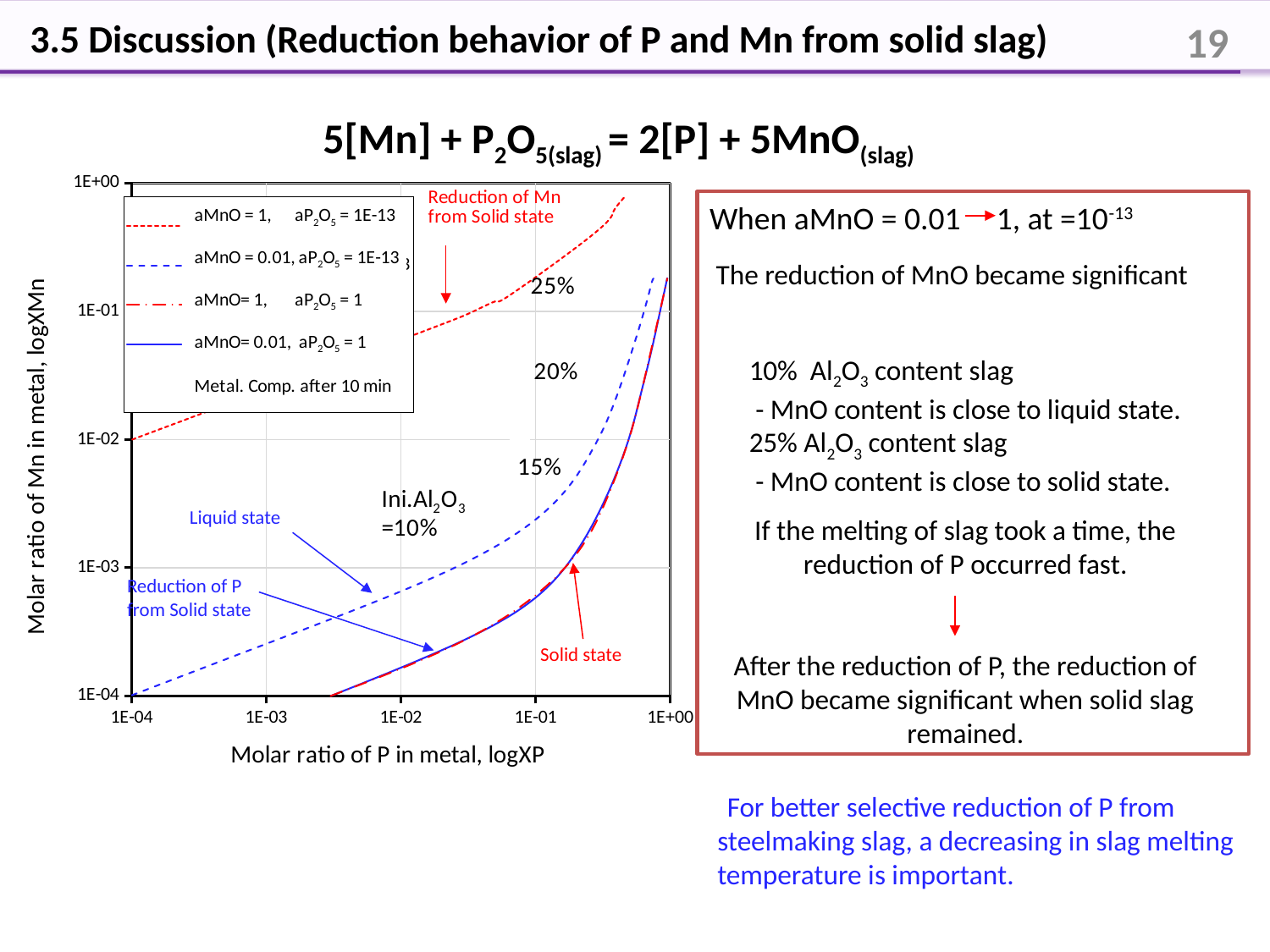
What kind of chart is shown on the slide? line chart Which legend series has the highest values across the plotted range? aMnO = 1, aP2O5 = 1E-13 At x = 1E-02, which series is higher: aMnO = 1, aP2O5 = 1E-13 or aMnO = 0.01, aP2O5 = 1E-13? aMnO = 1, aP2O5 = 1E-13 How many tick labels are shown on the x axis of the chart? 5 At x = 1E-02, is the value of the aMnO = 0.01, aP2O5 = 1 curve greater or less than 1E-03? less At x = 1E-01, is the value of the aMnO = 0.01, aP2O5 = 1E-13 curve greater or less than 1E-03? greater At x = 1E-03, is the value of the aMnO = 1, aP2O5 = 1E-13 curve greater or less than 1E-02? greater What is the title of the x axis of the chart? Molar ratio of P in metal, logXP Do the curves rise or fall as the molar ratio of P in metal increases along the x axis? rise Which two legend series overlap almost completely on the chart? aMnO = 1, aP2O5 = 1 and aMnO = 0.01, aP2O5 = 1